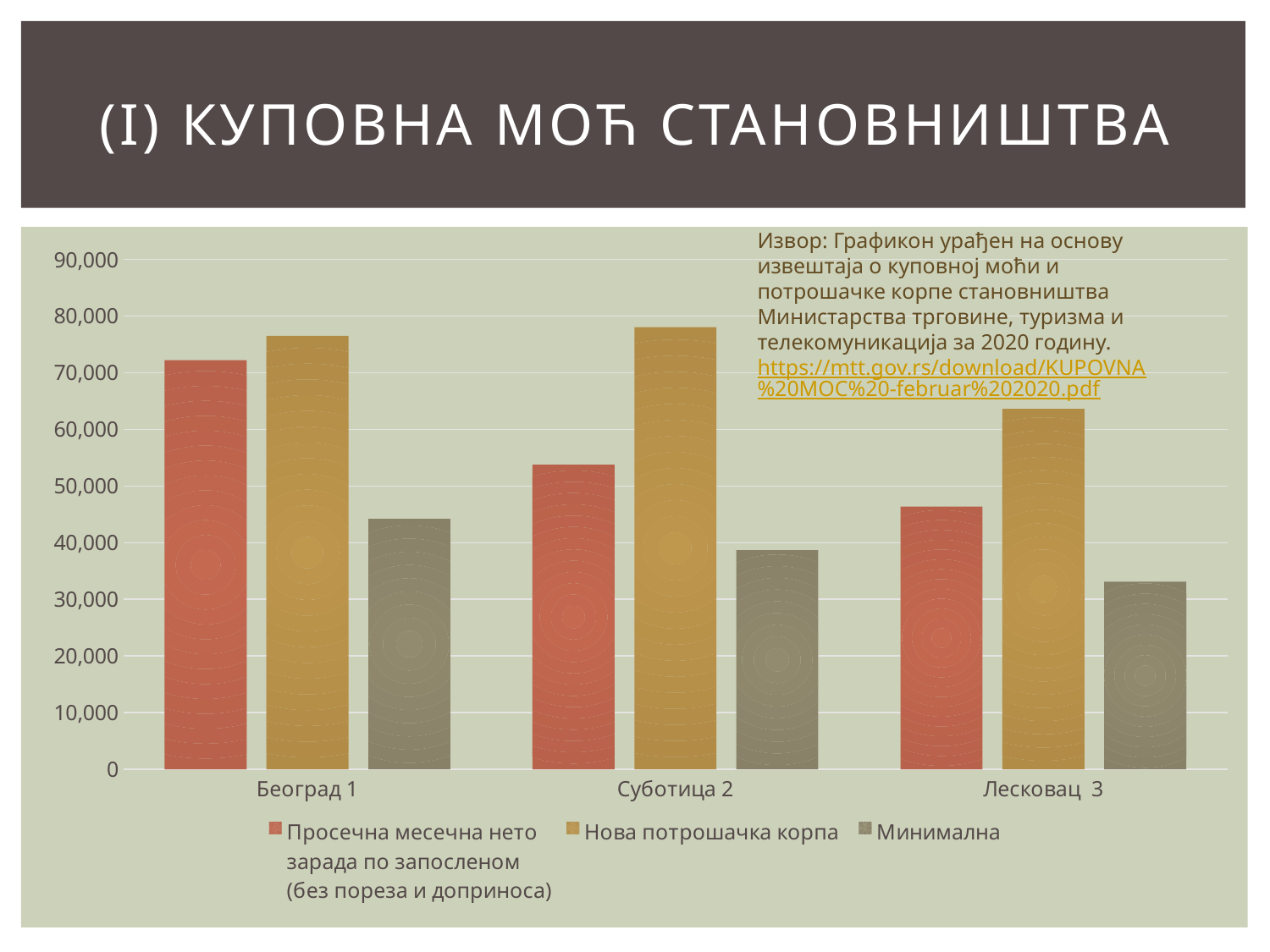
Do the values of Просечна месечна нето зарада по запосленом rise or fall from Београд 1 to Лесковац 3? fall Is the value of Просечна месечна нето зарада по запосленом for Лесковац 3 greater or less than 50,000? less How many cities (categories) are shown on the x axis? 3 Is the value of Минимална for Лесковац 3 greater or less than 40,000? less How many series does the legend list? 3 Which city has the lowest value for Минимална? Лесковац 3 What kind of chart is shown on the slide? bar chart Which city has the highest value for Просечна месечна нето зарада по запосленом? Београд 1 Is the value of Просечна месечна нето зарада по запосленом for Београд 1 greater or less than 60,000? greater For Суботица 2, which is larger: Просечна месечна нето зарада по запосленом or Нова потрошачка корпа? Нова потрошачка корпа Which series is shown in grey in the legend? Минимална